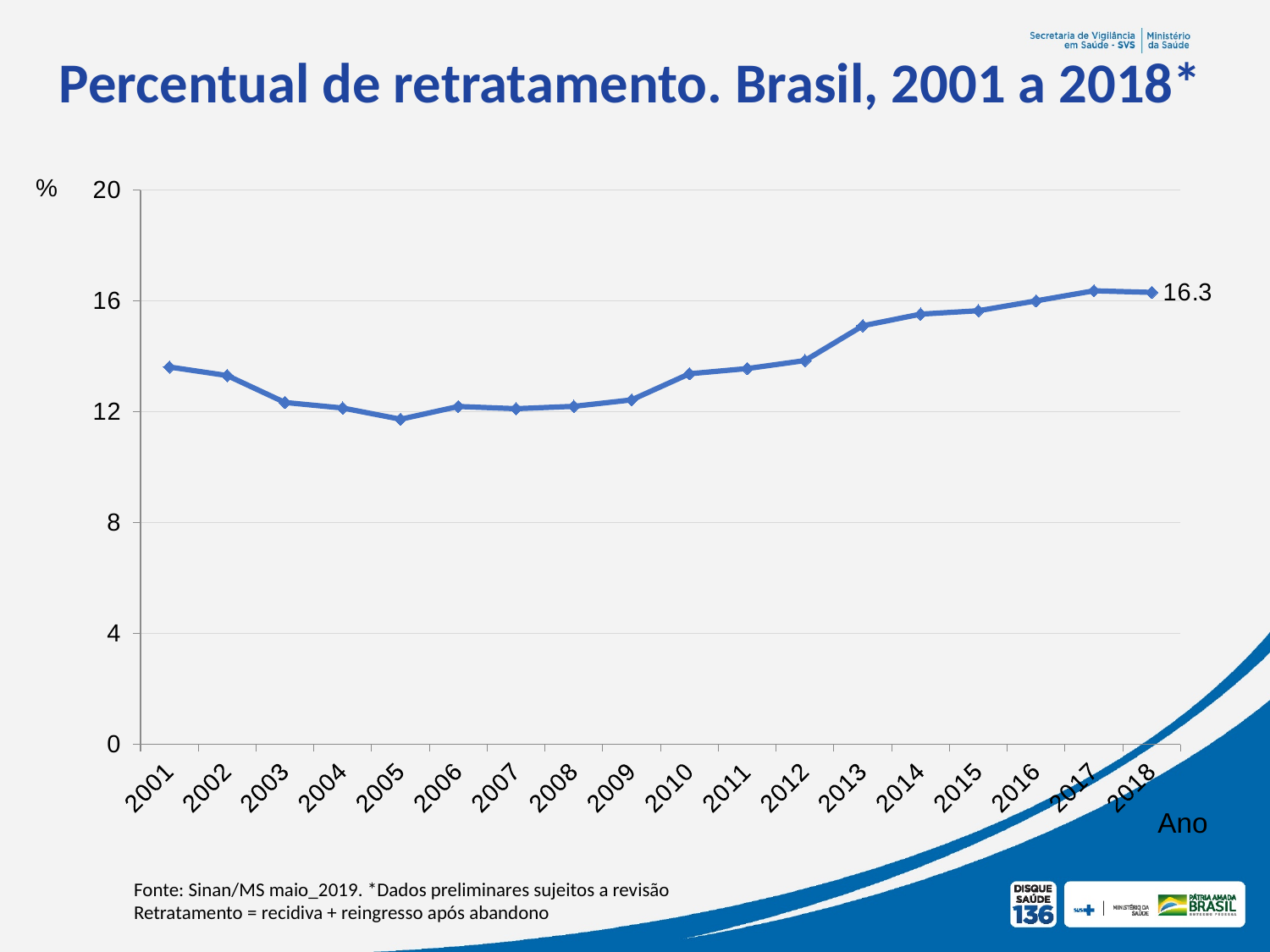
Is the value for 2014 greater or less than 16? less Is the value for 2005 greater or less than 12? less Which is larger, the value for 2001 or the value for 2009? 2001 Do the values rise or fall from 2009 to 2017? rise How many years are plotted on the chart? 18 What kind of chart is shown? line chart What is the value for 2018? 16.3 What is the title of the chart? Percentual de retratamento. Brasil, 2001 a 2018* Is the value for 2013 greater or less than 12? greater Which year has the lowest value? 2005 Which is larger, the value for 2013 or the value for 2005? 2013